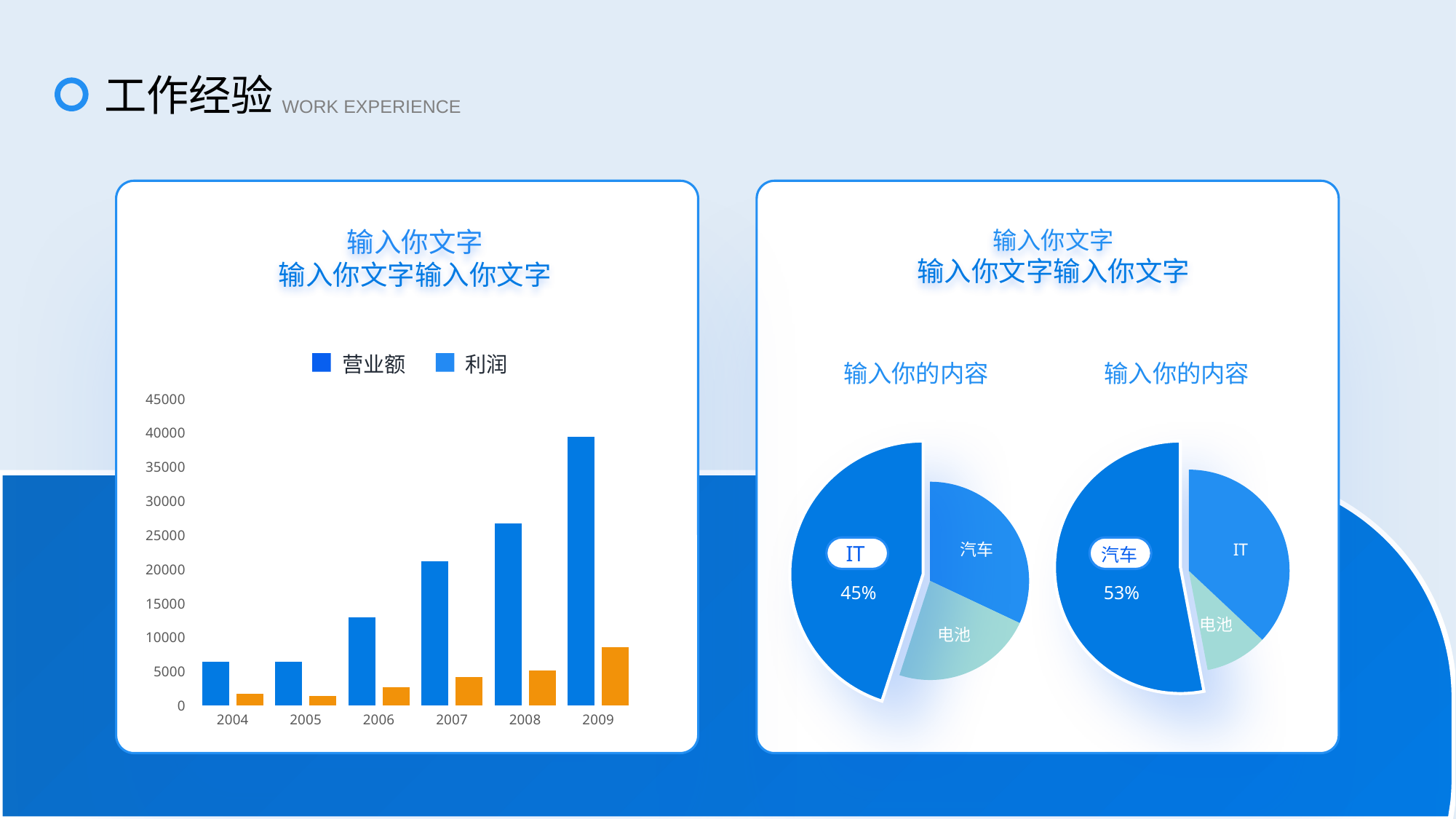
In the bar chart on the left, which is larger, the 营业额 for 2007 or for 2008? 2008 In the bar chart on the left, how many series does the legend list? 2 In the bar chart on the left, is the 利润 value for 2009 greater or less than 10000? less In the bar chart on the left, which year has the highest 营业额? 2009 In the right pie chart, which slice is the smallest? 电池 In the bar chart on the left, is the 营业额 value for 2006 greater or less than 15000? less In the bar chart on the left, is the 营业额 value for 2009 greater or less than 35000? greater In the bar chart on the left, does 营业额 generally rise or fall from 2004 to 2009? rise In the left pie chart, what share does the IT slice have? 45% In the right pie chart, what share does the 汽车 slice have? 53% In the bar chart on the left, how many years are shown on the x axis? 6 What kind of chart is the chart on the left side of the slide? bar chart